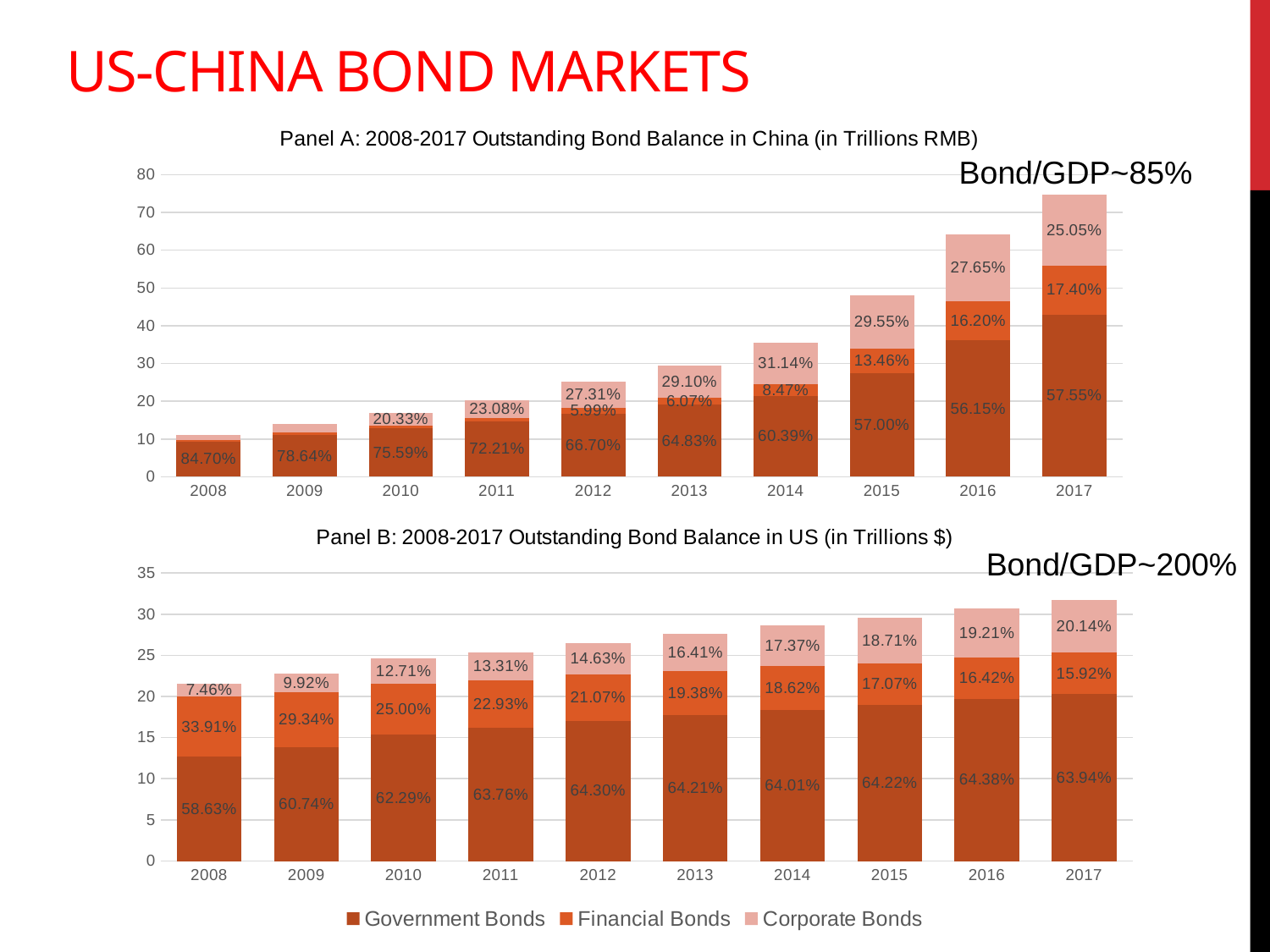
In Panel B, what percentage label is shown for Financial Bonds in 2008? 33.91% In Panel A, what percentage label is shown for Financial Bonds in 2016? 16.20% In Panel B, which year has the shortest total stacked bar? 2008 In Panel B, is the total outstanding bond balance for 2008 greater or less than 20? greater What kind of chart is Panel A? Stacked bar chart In Panel B, what percentage label is shown for Corporate Bonds in 2017? 20.14% In Panel A, which year has the tallest total stacked bar? 2017 How many series does the legend list? 3 In Panel B, by how many percentage points did the Corporate Bonds share change from 2008 (7.46%) to 2017 (20.14%)? 12.68 percentage points In Panel A, is the total outstanding bond balance for 2017 greater or less than 70? greater In Panel A, what percentage label is shown for Government Bonds in 2008? 84.70% In Panel A, which is larger: the Corporate Bonds share in 2014 or in 2017? 2014